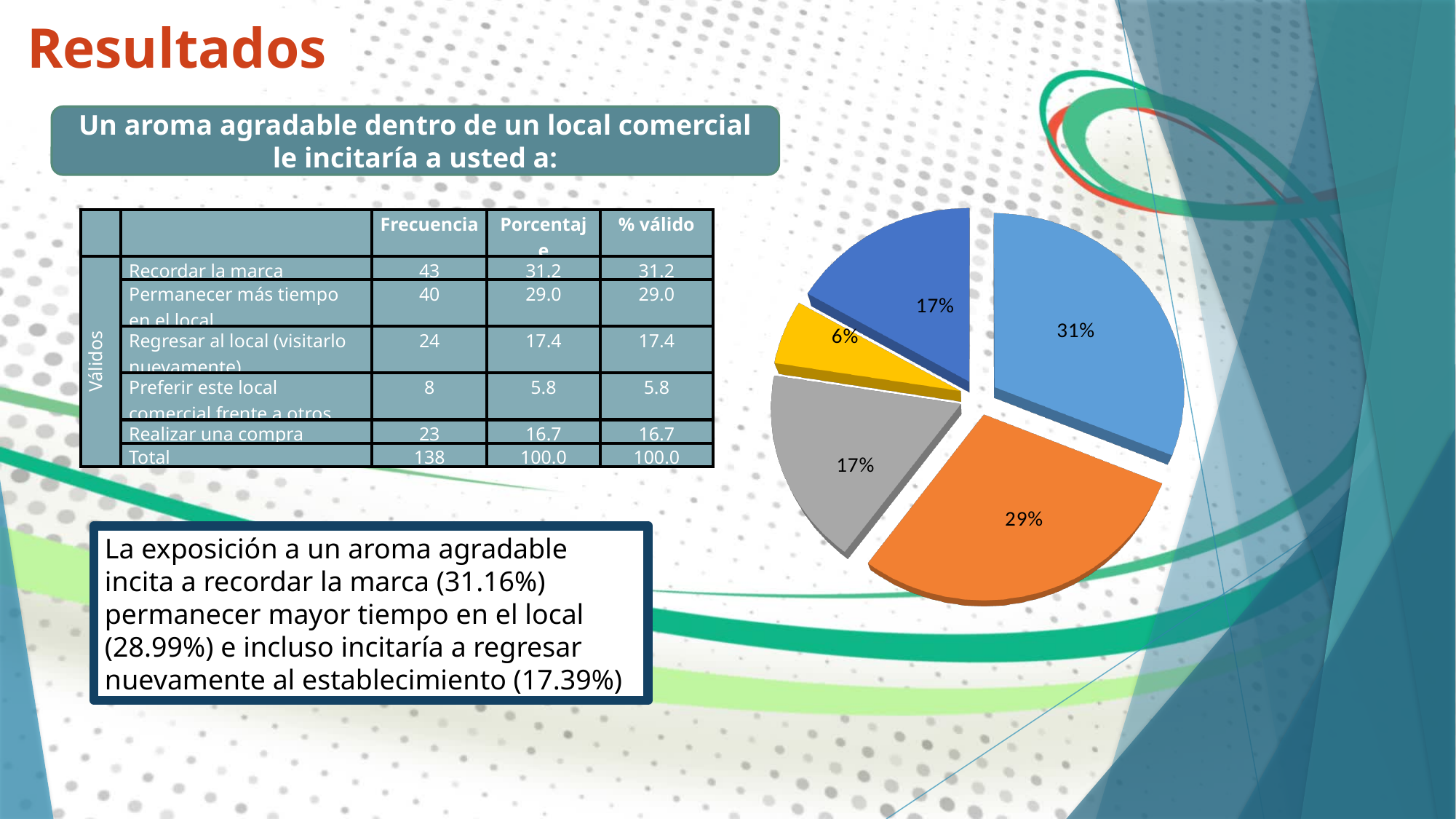
What value is labelled on the orange slice of the pie chart? 29% What colour is the largest slice of the pie chart? Light blue What is the value shown on the largest slice of the pie chart? 31% Does the pie chart include a legend? No Which slice of the pie chart is larger, the orange slice or the grey slice? The orange slice What value is labelled on the grey slice of the pie chart? 17% How many slices of the pie chart are labelled 17%? 2 What value is labelled on the yellow slice of the pie chart? 6% What is the difference in percentage points between the largest slice (31%) and the smallest slice (6%) of the pie chart? 25 percentage points What kind of chart is shown on the right side of the slide? Pie chart What is the value shown on the smallest slice of the pie chart? 6% How many slices does the pie chart have? 5